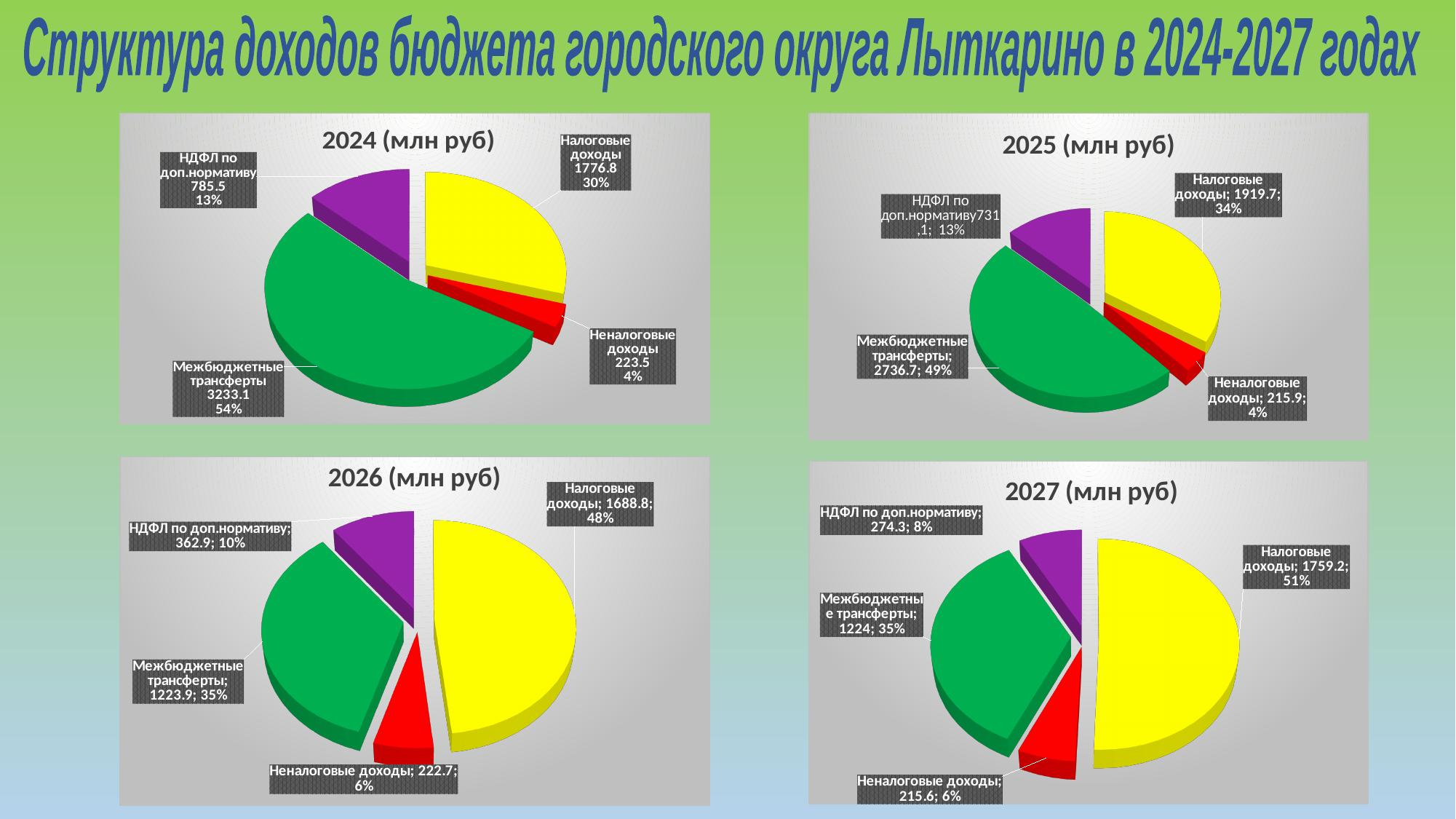
In the 2027 (млн руб) chart, what share of the pie is Налоговые доходы? 51% In the 2026 (млн руб) chart, which is larger, Налоговые доходы or Межбюджетные трансферты? Налоговые доходы What type of chart is used for the 2026 (млн руб) data? Pie chart In the 2025 (млн руб) chart, what is the value for Налоговые доходы? 1919.7 How many categories does the 2027 (млн руб) chart show? 4 In the 2024 (млн руб) chart, which category is the smallest? Неналоговые доходы In the 2025 (млн руб) chart, which category is the largest? Межбюджетные трансферты In the 2027 (млн руб) chart, what is the difference between Налоговые доходы and Межбюджетные трансферты? 535.2 In the 2025 (млн руб) chart, what share of the pie is Неналоговые доходы? 4% In the 2026 (млн руб) chart, what is the value for НДФЛ по доп.нормативу? 362.9 In the 2024 (млн руб) chart, what share of the pie is Налоговые доходы? 30% In the 2024 (млн руб) chart, what is the value for Межбюджетные трансферты? 3233.1